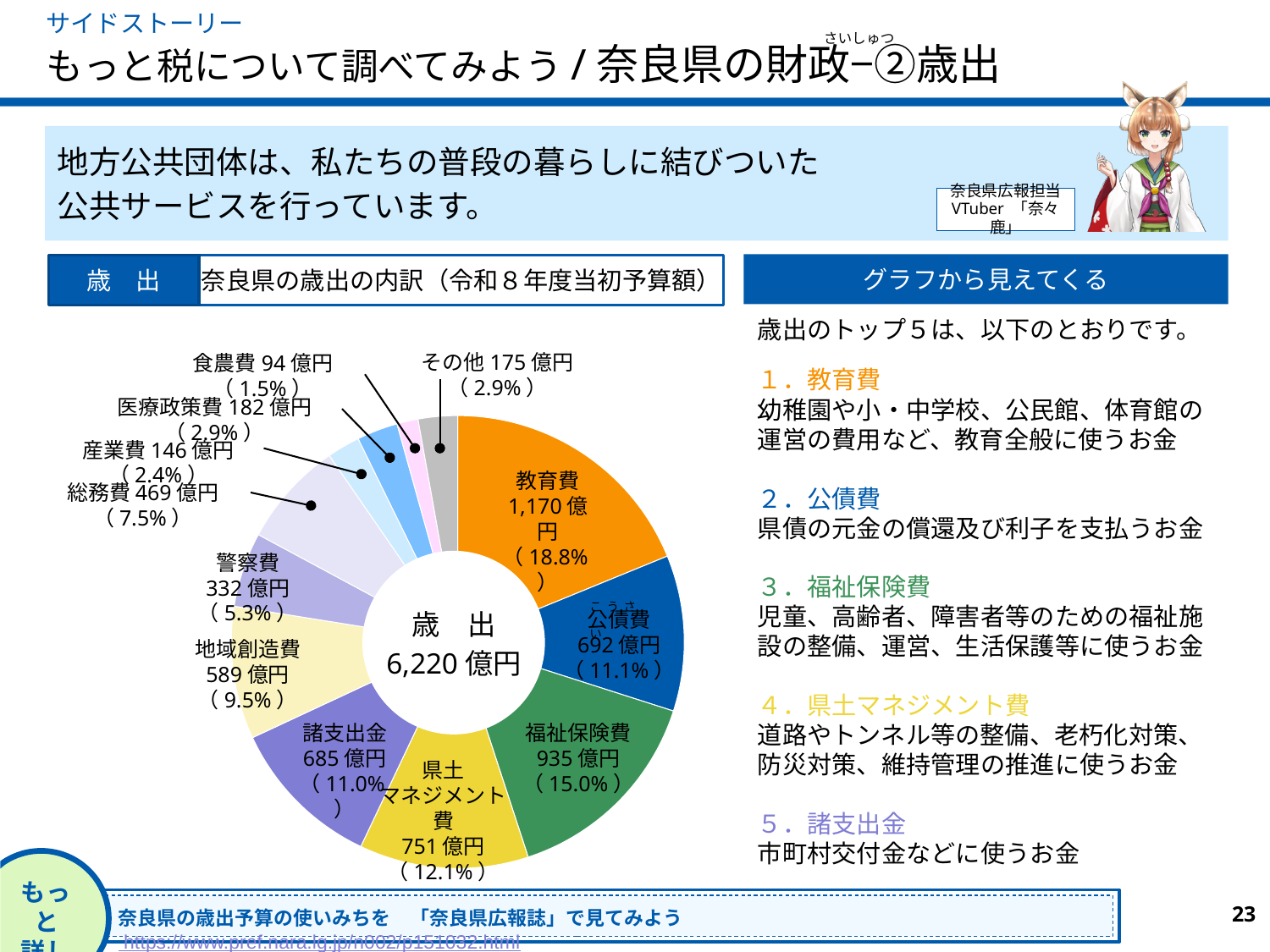
What is the total expenditure (歳出) shown in the centre of the chart? 6,220 億円 What is the value for 県土マネジメント費? 751 億円 What is the value for 教育費? 1,170 億円 What is the difference between 教育費 and 福祉保険費 in 億円? 235 億円 Which category has the largest slice of the pie? 教育費 Which category has the smallest slice of the pie? 食農費 What share of the pie does 福祉保険費 represent? 15.0% What share of the pie does 総務費 represent? 7.5% Which is larger, 公債費 or 諸支出金? 公債費 What is the title of the chart? 奈良県の歳出の内訳（令和８年度当初予算額） How many categories are shown in the pie chart? 12 What kind of chart is shown on the slide? Pie (doughnut) chart